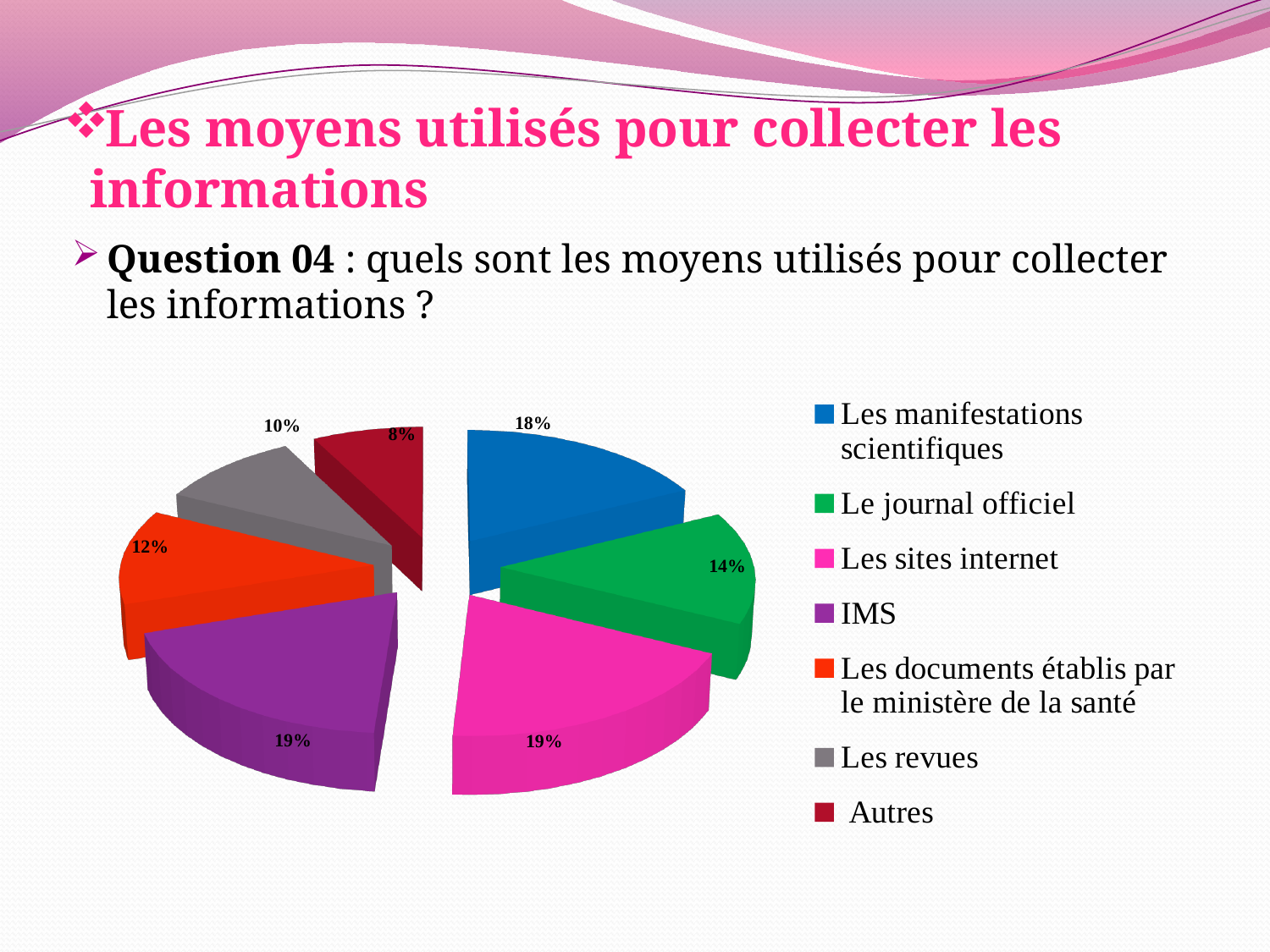
Which category has the smallest slice of the pie chart? Autres What percentage of the pie chart corresponds to Les manifestations scientifiques? 18% What percentage is shown for Les sites internet? 19% What percentage is shown for Les documents établis par le ministère de la santé? 12% What kind of chart is shown on the slide? pie chart Which colour represents IMS in the pie chart? purple What is the difference in percentage points between IMS and Les revues? 9 Which is larger: the share for Le journal officiel or the share for Autres? Le journal officiel What percentage is shown for Les revues? 10% What is the difference in percentage points between Les manifestations scientifiques and Le journal officiel? 4 How many categories does the pie chart legend list? 7 What share does Le journal officiel have in the pie chart? 14%